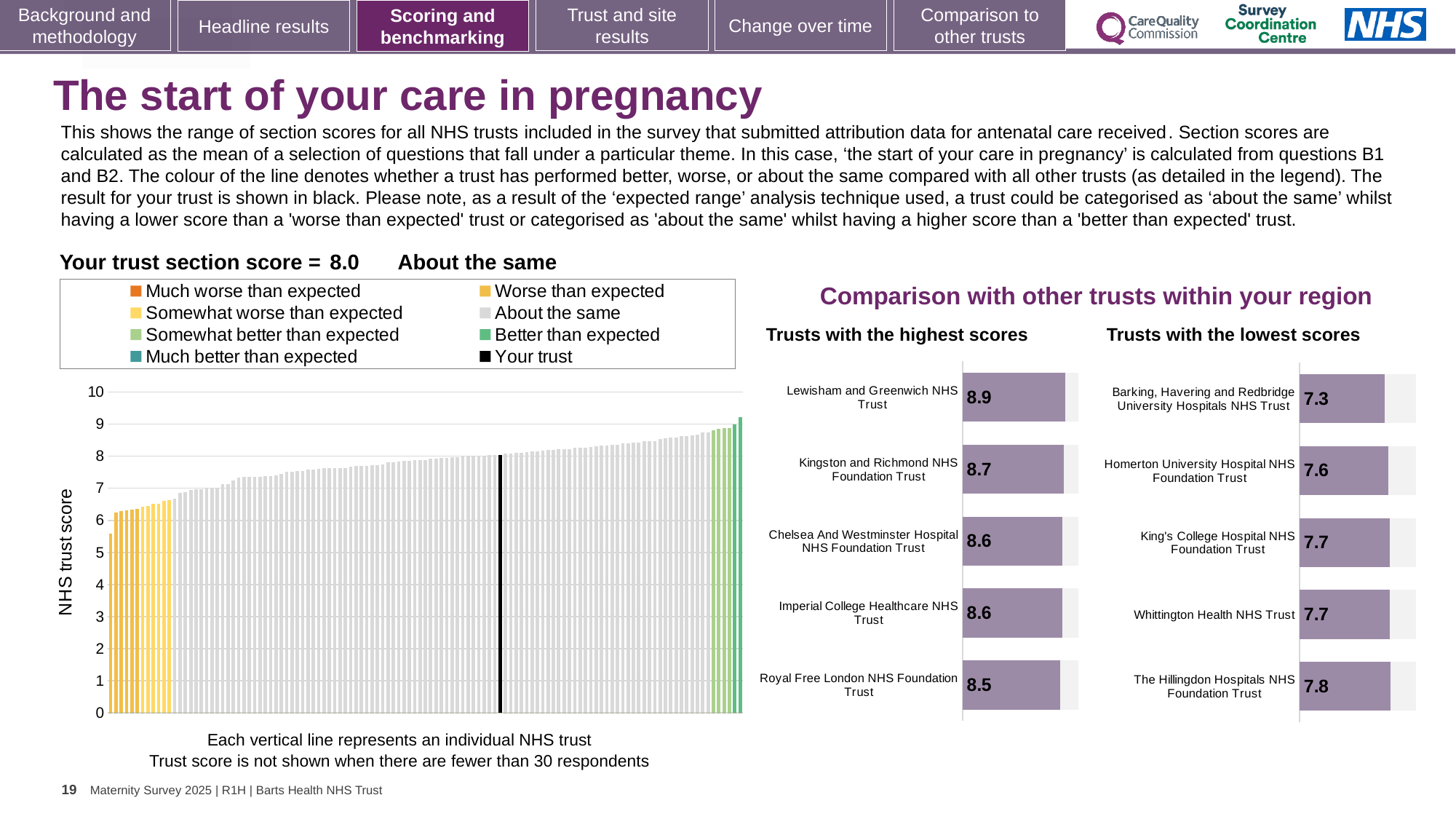
In the large chart on the left, is the value of the leftmost bar greater or less than 7? less In the 'Trusts with the highest scores' chart, what is the score for Lewisham and Greenwich NHS Trust? 8.9 In the large chart on the left, what is the section score for your trust? 8.0 In the 'Trusts with the highest scores' chart, what is the difference between the scores of Lewisham and Greenwich NHS Trust and Royal Free London NHS Foundation Trust? 0.4 In the 'Trusts with the lowest scores' chart, which has the larger score: Homerton University Hospital NHS Foundation Trust or King's College Hospital NHS Foundation Trust? King's College Hospital NHS Foundation Trust In the large chart on the left, do the trust scores rise or fall from left to right? rise What kind of chart is the large chart on the left showing NHS trust scores? bar chart In the 'Trusts with the highest scores' chart, which trust has the highest score? Lewisham and Greenwich NHS Trust What is the label on the vertical axis of the large chart on the left? NHS trust score In the 'Trusts with the lowest scores' chart, which trust has the lowest score? Barking, Havering and Redbridge University Hospitals NHS Trust How many trusts are shown in the 'Trusts with the lowest scores' chart? 5 How many entries does the legend above the large chart on the left list? 8